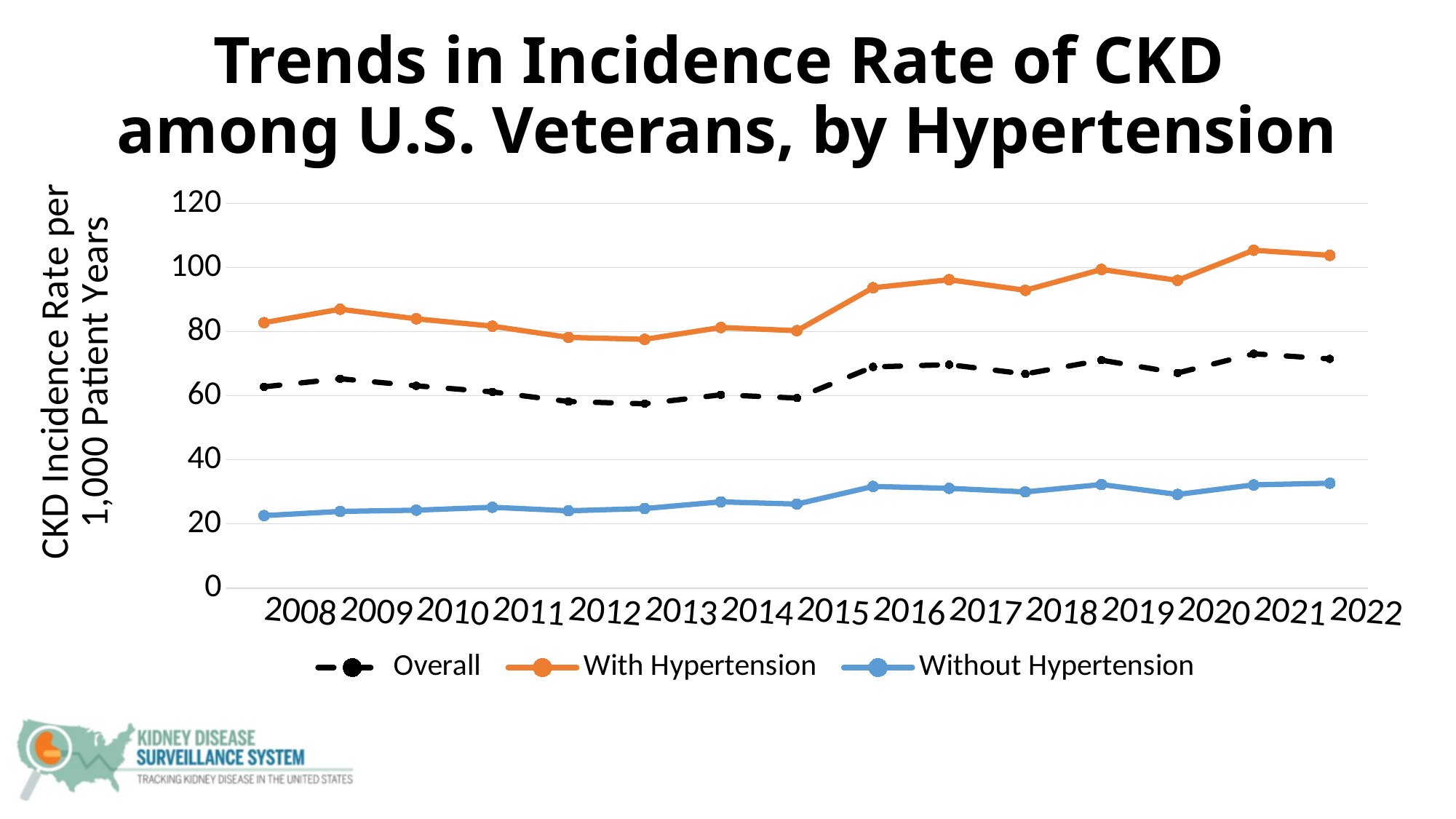
How many years are plotted along the x axis? 15 What type of chart is shown on the slide? Line chart Does the Without Hypertension line rise or fall from 2008 to 2022? Rise Is the value for With Hypertension in 2016 greater or less than 80? greater Is the value for Without Hypertension in 2008 greater or less than 40? less Is the value for Overall in 2021 greater or less than 60? greater Which series has the highest values across all years? With Hypertension In 2015, which is larger: the value for With Hypertension or the value for Without Hypertension? With Hypertension How many series does the legend list? 3 What is the y-axis title of the chart? CKD Incidence Rate per 1,000 Patient Years Does the With Hypertension line rise or fall from 2015 to 2016? Rise